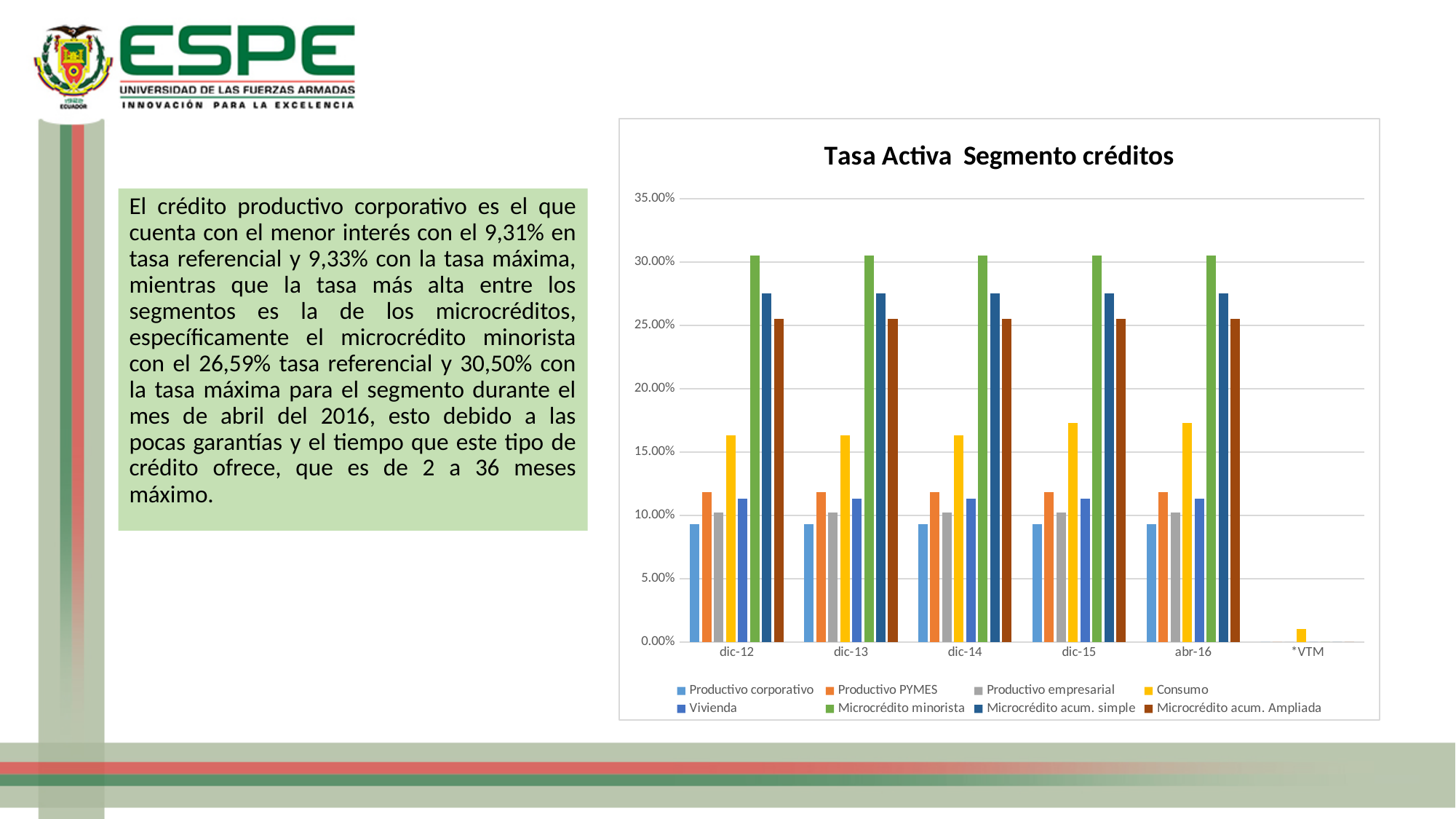
At dic-15, which is larger: Microcrédito acum. simple or Microcrédito acum. Ampliada? Microcrédito acum. simple Which series has the lowest value in the abr-16 group? Productivo corporativo Does the value for Microcrédito minorista rise, fall, or stay about the same from dic-12 to abr-16? stays about the same At dic-14, which is larger: Consumo or Vivienda? Consumo Is the value for Microcrédito acum. simple at dic-13 greater or less than 25.00%? greater What kind of chart is shown on the slide? bar chart Is the value for Productivo corporativo at dic-14 greater or less than 10.00%? less How many categories are shown on the x axis of the chart? 6 Is the value for Consumo at dic-15 greater or less than 15.00%? greater Which series has the highest value in the dic-12 group? Microcrédito minorista How many series does the chart's legend list? 8 What is the title of the chart? Tasa Activa Segmento créditos